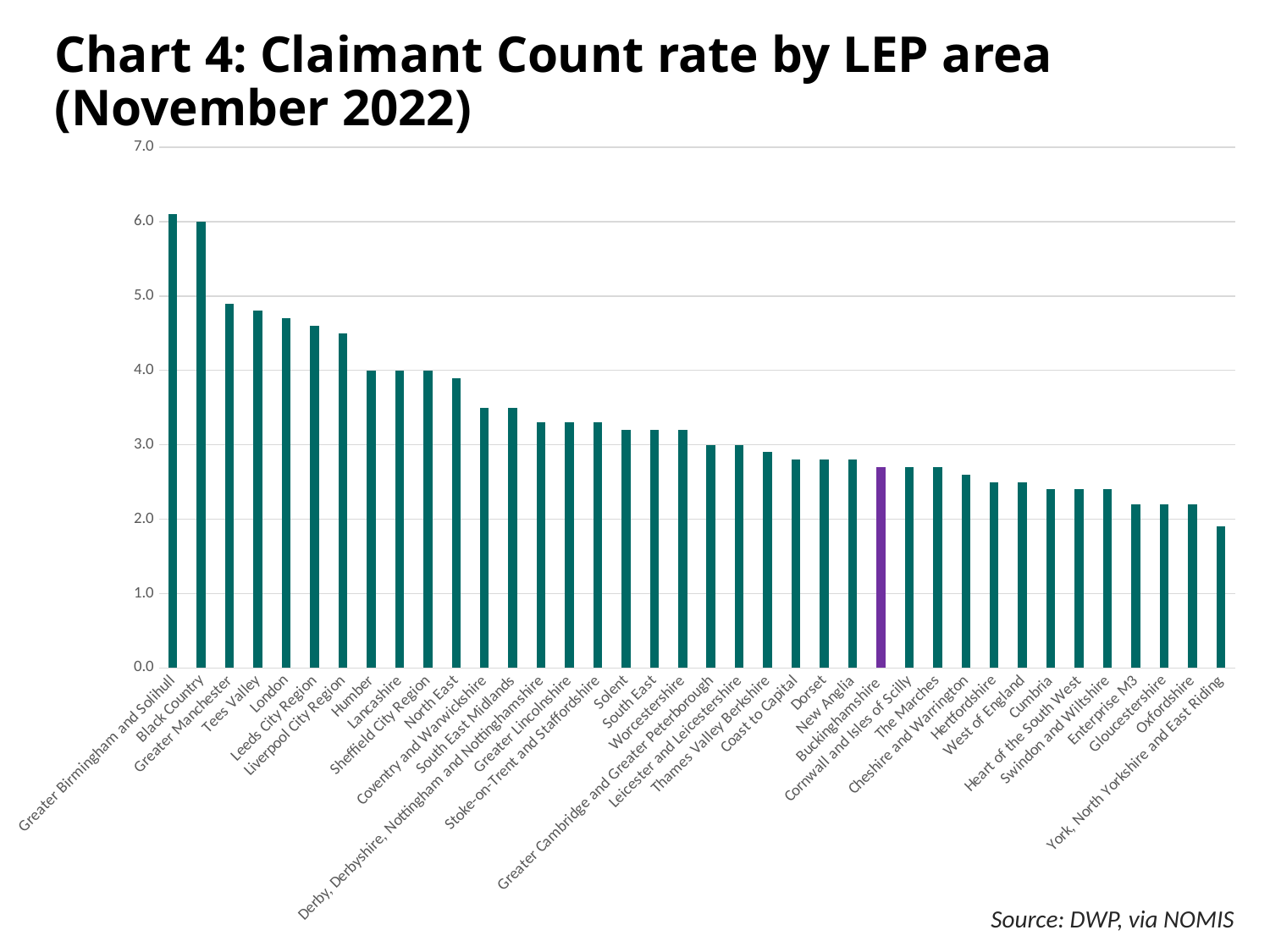
Which LEP area has the highest Claimant Count rate? Greater Birmingham and Solihull Which has the higher Claimant Count rate, Oxfordshire or Tees Valley? Tees Valley Is the value for Cumbria greater or less than 3.0? less Which has the higher Claimant Count rate, Greater Manchester or Humber? Greater Manchester What kind of chart is shown on the slide? Bar chart Do the values generally rise or fall moving from left to right along the x axis? Fall How many LEP areas are plotted in the chart? 38 Which LEP area's bar is highlighted in purple rather than teal? Buckinghamshire Which LEP area has the lowest Claimant Count rate? York, North Yorkshire and East Riding Is the value for London greater or less than 4.0? greater Is the value for Coventry and Warwickshire greater or less than 4.0? less